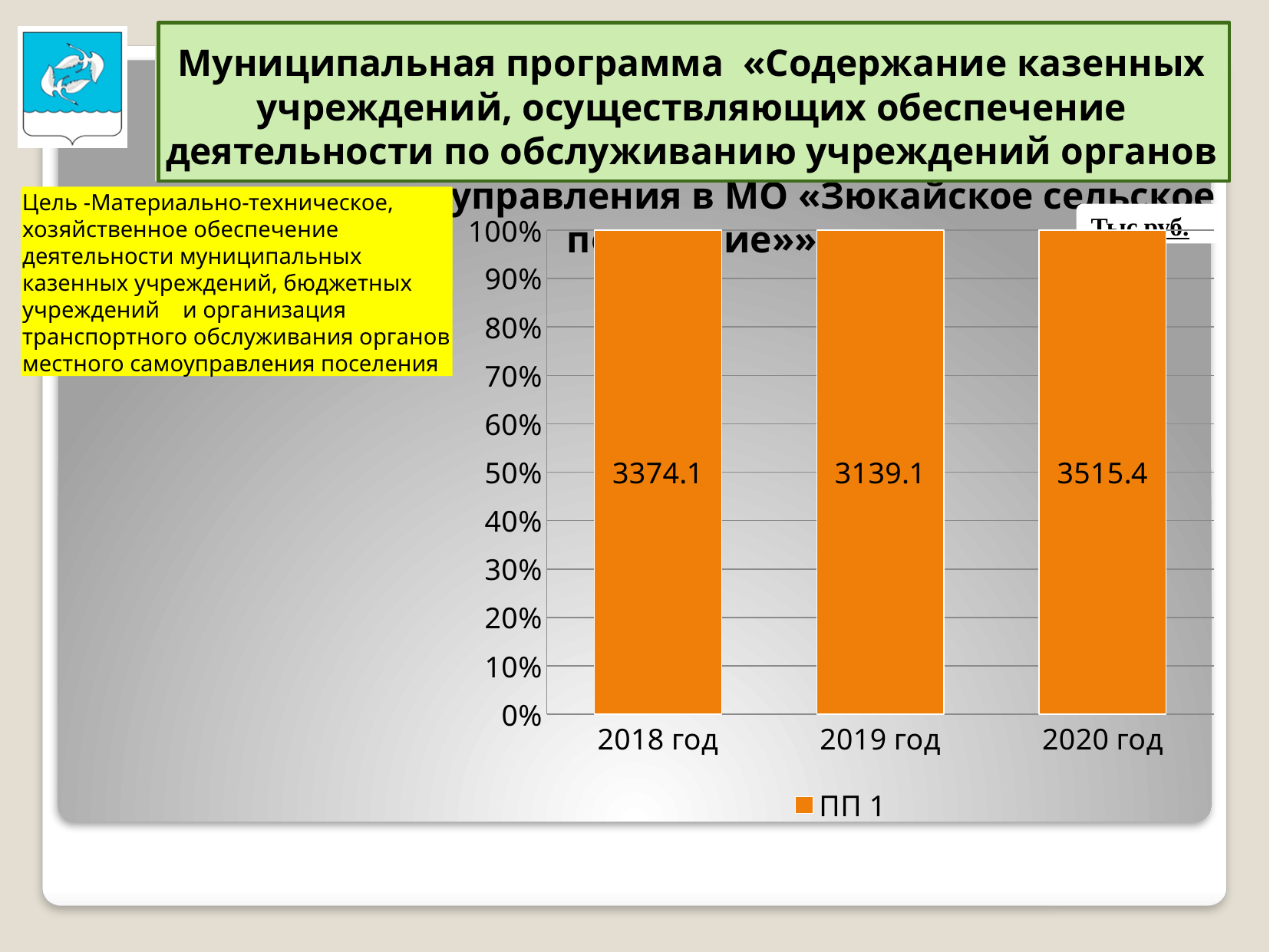
What is the data label on the bar for 2020 год? 3515.4 What is the difference between the labelled values for 2018 год and 2019 год? 235 How many series does the chart legend list? 1 How many years are shown on the x axis of the chart? 3 Which year has the highest labelled value? 2020 год What is the difference between the labelled values for 2020 год and 2018 год? 141.3 Which has the larger labelled value, 2019 год or 2020 год? 2020 год What is the data label on the bar for 2019 год? 3139.1 What is the name of the series in the chart legend? ПП 1 Which year has the lowest labelled value? 2019 год What kind of chart is shown on the slide? bar chart What is the data label on the bar for 2018 год? 3374.1